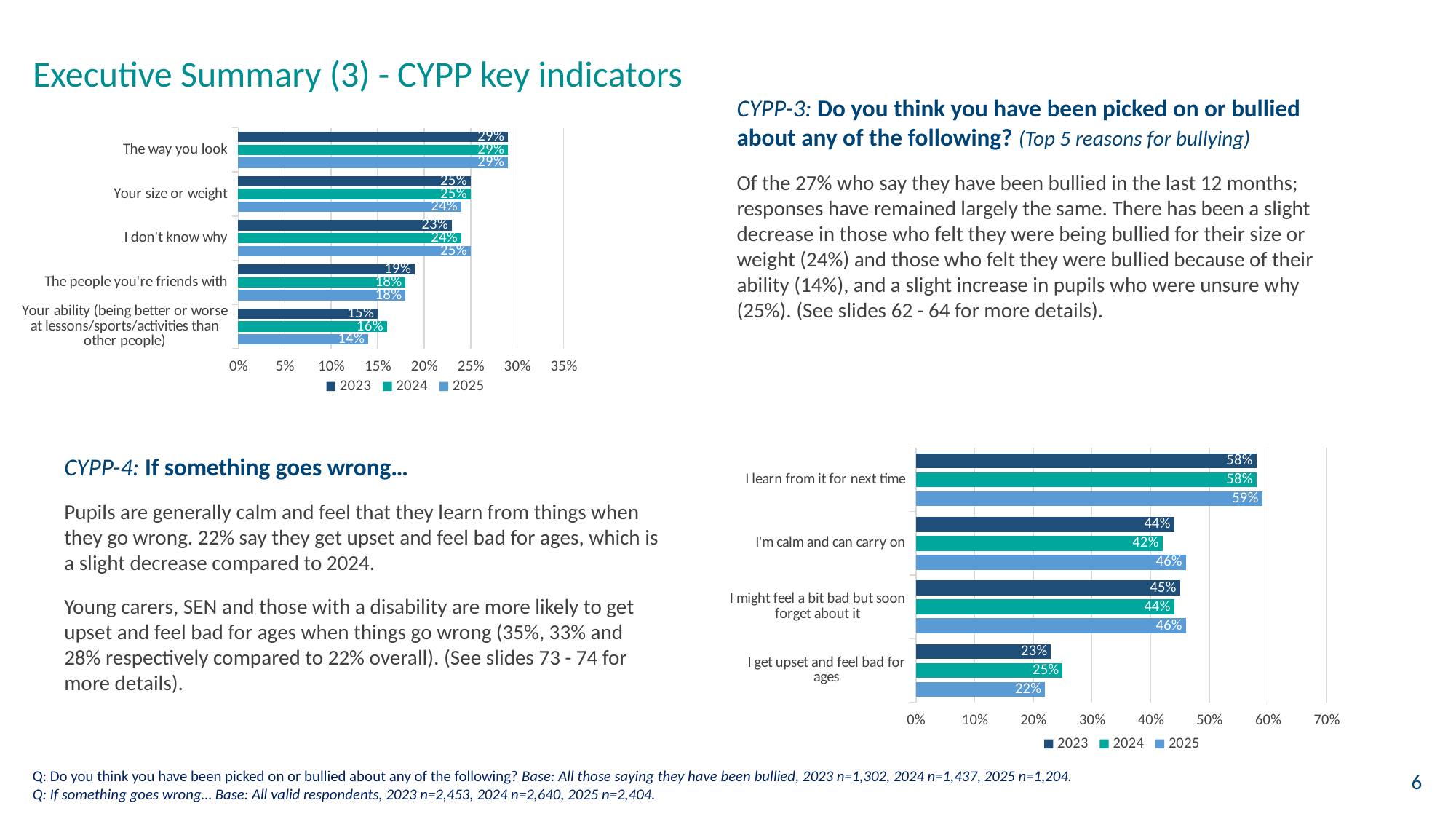
In the bottom-right chart, which is larger for 2023: 'I'm calm and can carry on' or 'I get upset and feel bad for ages'? I'm calm and can carry on In the top-left chart, what is the 2023 value for 'I don't know why'? 23% How many categories are shown in the bottom-right chart? 4 In the top-left chart, which category has the highest 2025 value? The way you look In the top-left chart, how many series does the legend list? 3 In the top-left chart, what is the difference between the 2025 values for 'The way you look' and 'The people you're friends with'? 11% What type of chart is the bottom-right chart? Bar chart In the top-left chart, which category has the lowest 2024 value? Your ability (being better or worse at lessons/sports/activities than other people) In the top-left chart, what is the 2025 value for 'Your size or weight'? 24% In the bottom-right chart, what is the difference between the 2025 values for 'I'm calm and can carry on' and 'I get upset and feel bad for ages'? 24% In the bottom-right chart, what is the 2025 value for 'I learn from it for next time'? 59% In the bottom-right chart, what is the 2024 value for 'I get upset and feel bad for ages'? 25%